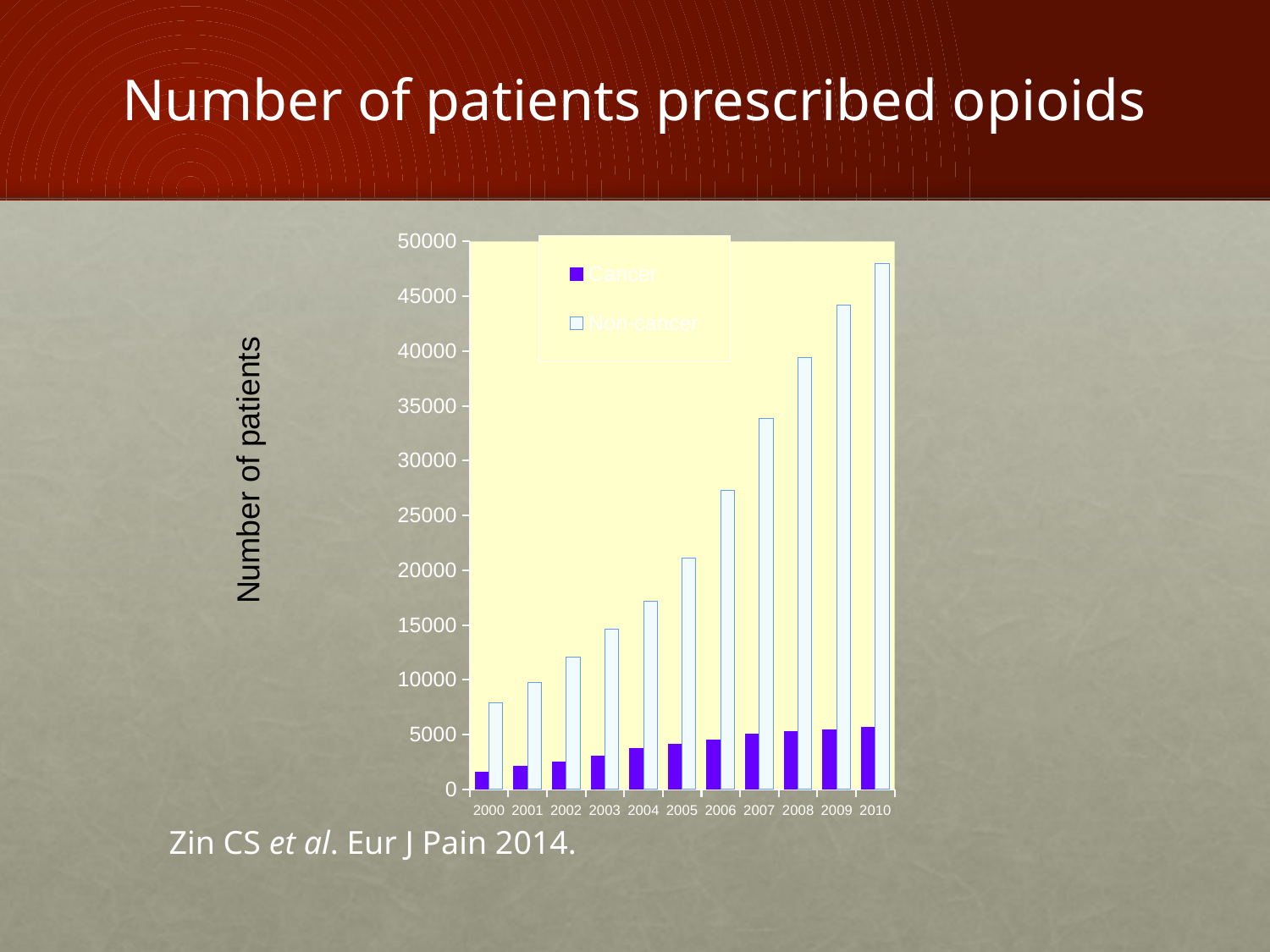
How many years are shown on the x axis? 11 Which year has the lowest Non-cancer value? 2000 Do the Non-cancer values rise or fall from 2000 to 2010? rise What kind of chart is shown on the slide? bar chart Is the Non-cancer value for 2000 greater or less than 10000? less Which year has the highest Non-cancer value? 2010 Which year has the highest Cancer value? 2010 How many series does the legend list? 2 What is the label on the y axis? Number of patients Is the Cancer value for 2000 greater or less than 5000? less In 2010, which is larger, the Cancer value or the Non-cancer value? Non-cancer Is the Non-cancer value for 2010 greater or less than 45000? greater